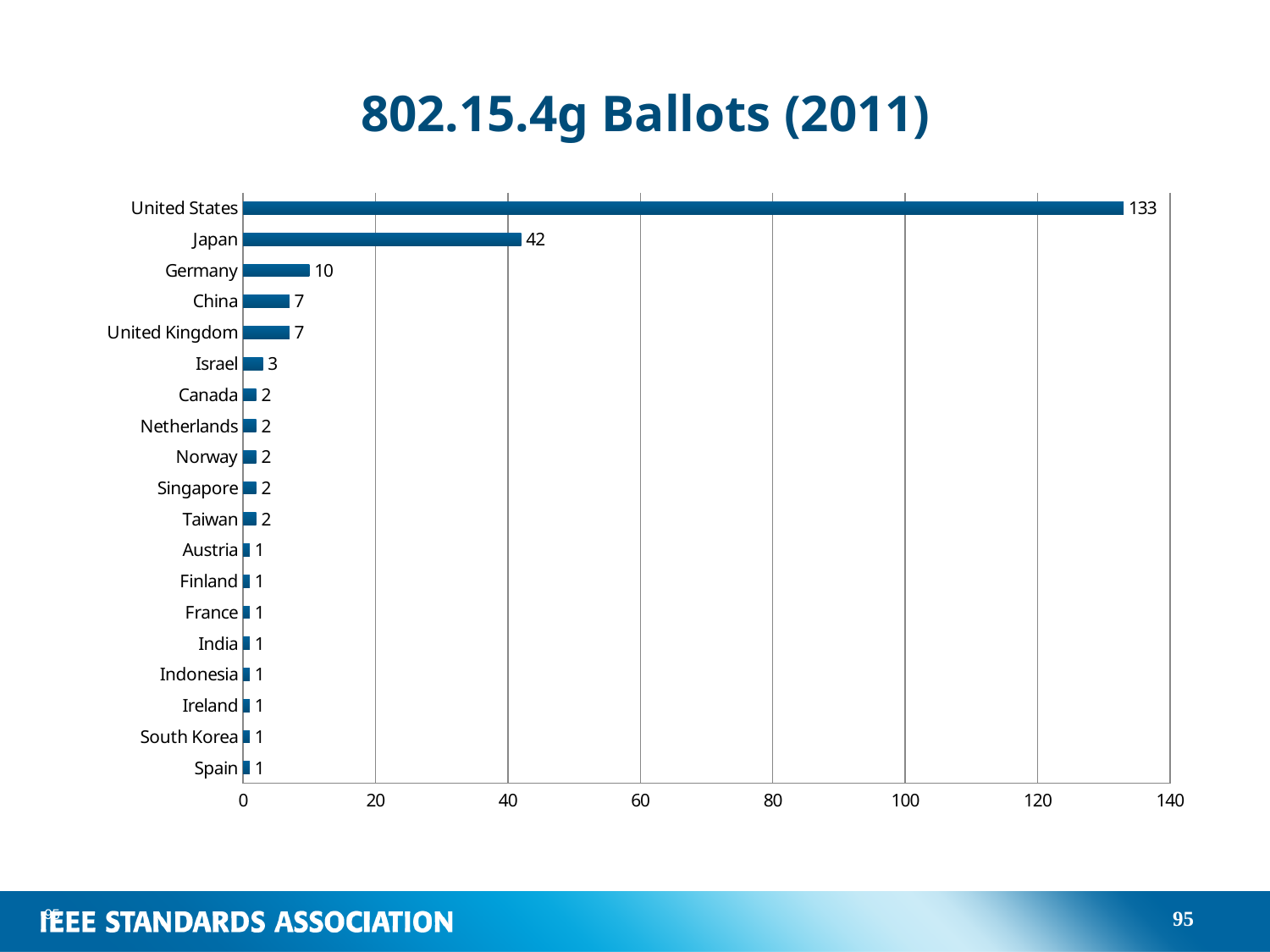
What is the value for Japan? 42 Which country has the highest value? United States Which is larger, the value for China or the value for Israel? China What is the title of the chart? 802.15.4g Ballots (2011) What is the value for Germany? 10 What is the difference between the values for the United States and Japan? 91 How many countries are shown on the chart? 19 What is the difference between the values for Japan and Germany? 32 What kind of chart is this? bar chart What is the value for the United Kingdom? 7 Is the value for the United States greater or less than 120? greater What is the value for Israel? 3